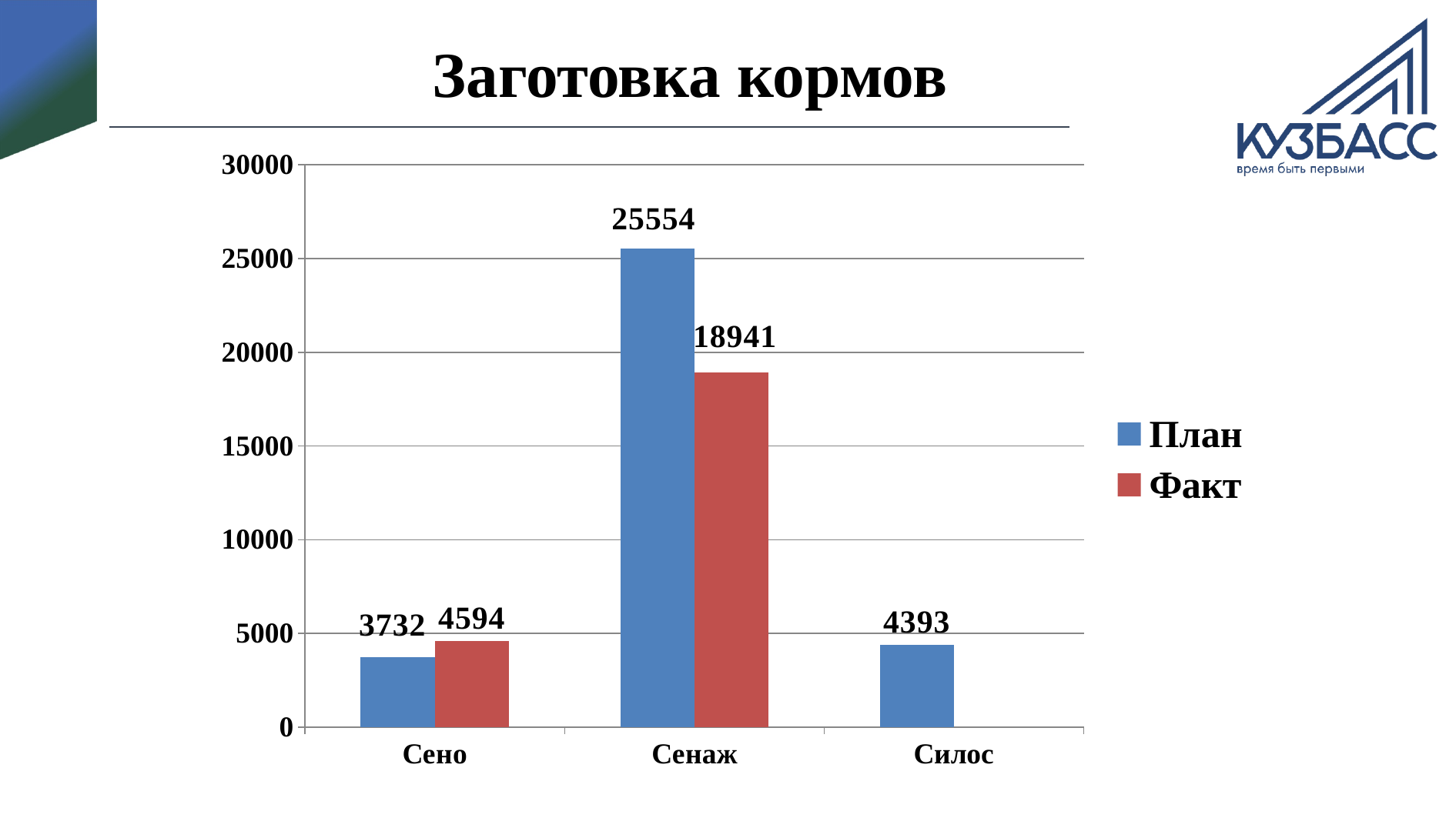
How many series does the legend list? 2 What is the difference between the Факт and План values for Сено? 862 Which category has the highest План value? Сенаж What kind of chart is shown on the slide? Bar chart Which is larger for Сено, the План value or the Факт value? Факт What is the difference between the План and Факт values for Сенаж? 6613 What is the План value for Сенаж? 25554 What is the Факт value for Сено? 4594 Which category has the lowest План value? Сено What is the План value for Силос? 4393 What is the Факт value for Сенаж? 18941 How many categories are shown on the x axis? 3